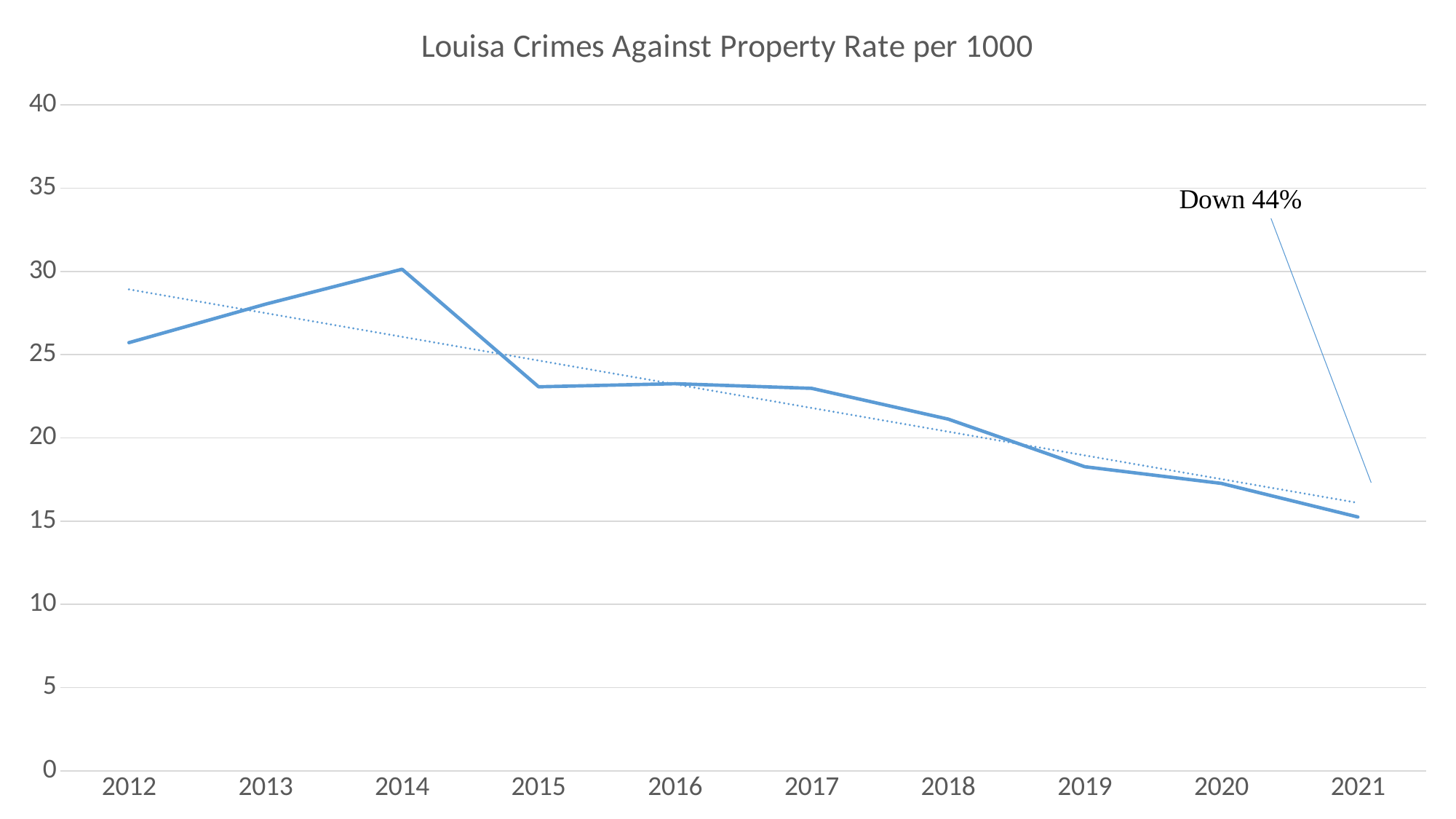
Which year has the higher rate, 2012 or 2021? 2012 Overall, does the crimes against property rate rise or fall from 2014 to 2021? fall Which year has the lowest crimes against property rate? 2021 What does the annotation on the chart say? Down 44% Is the value for 2015 greater or less than 25? less Is the value for 2014 greater or less than 25? greater Which year has the highest crimes against property rate? 2014 Which year has the higher rate, 2014 or 2015? 2014 What is the title of the chart? Louisa Crimes Against Property Rate per 1000 Is the value for 2021 greater or less than 20? less What kind of chart is shown on the slide? line chart How many years are plotted on the x axis? 10